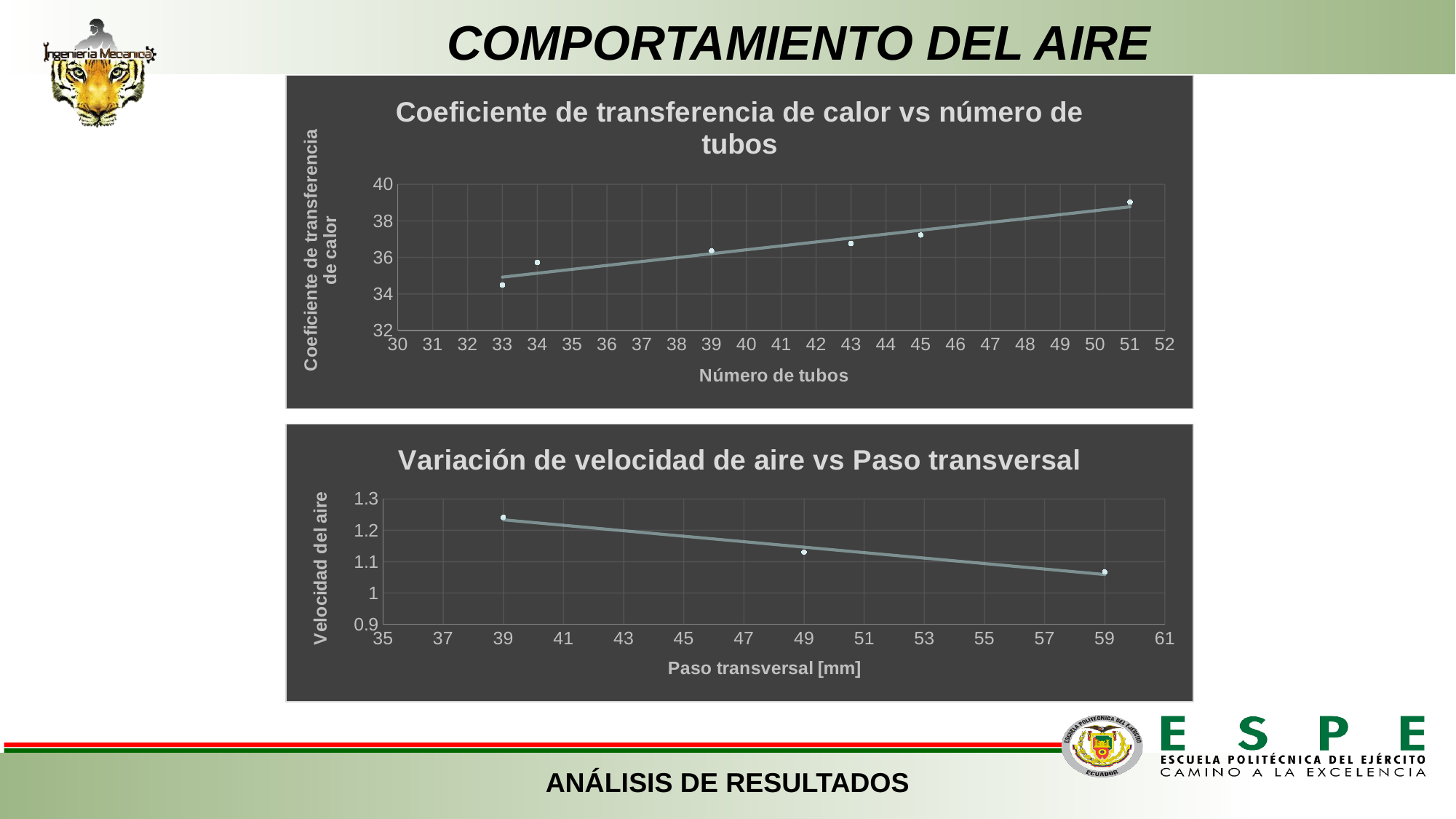
What is the x-axis title of the bottom chart, 'Variación de velocidad de aire vs Paso transversal'? Paso transversal [mm] In the top chart, 'Coeficiente de transferencia de calor vs número de tubos', is the value for 51 tubes greater or less than 38? greater In the bottom chart, 'Variación de velocidad de aire vs Paso transversal', do the values rise or fall as the paso transversal increases? fall In the bottom chart, 'Variación de velocidad de aire vs Paso transversal', is the value at 59 mm greater or less than 1.1? less What kind of chart is the top chart, 'Coeficiente de transferencia de calor vs número de tubos'? scatter chart In the top chart, 'Coeficiente de transferencia de calor vs número de tubos', is the value for 33 tubes greater or less than 36? less How many data points are plotted in the top chart, 'Coeficiente de transferencia de calor vs número de tubos'? 6 In the top chart, 'Coeficiente de transferencia de calor vs número de tubos', do the values rise or fall as the number of tubes increases? rise How many data points are plotted in the bottom chart, 'Variación de velocidad de aire vs Paso transversal'? 3 In the top chart, 'Coeficiente de transferencia de calor vs número de tubos', at which number of tubes is the coefficient lowest? 33 In the top chart, 'Coeficiente de transferencia de calor vs número de tubos', at which number of tubes is the coefficient highest? 51